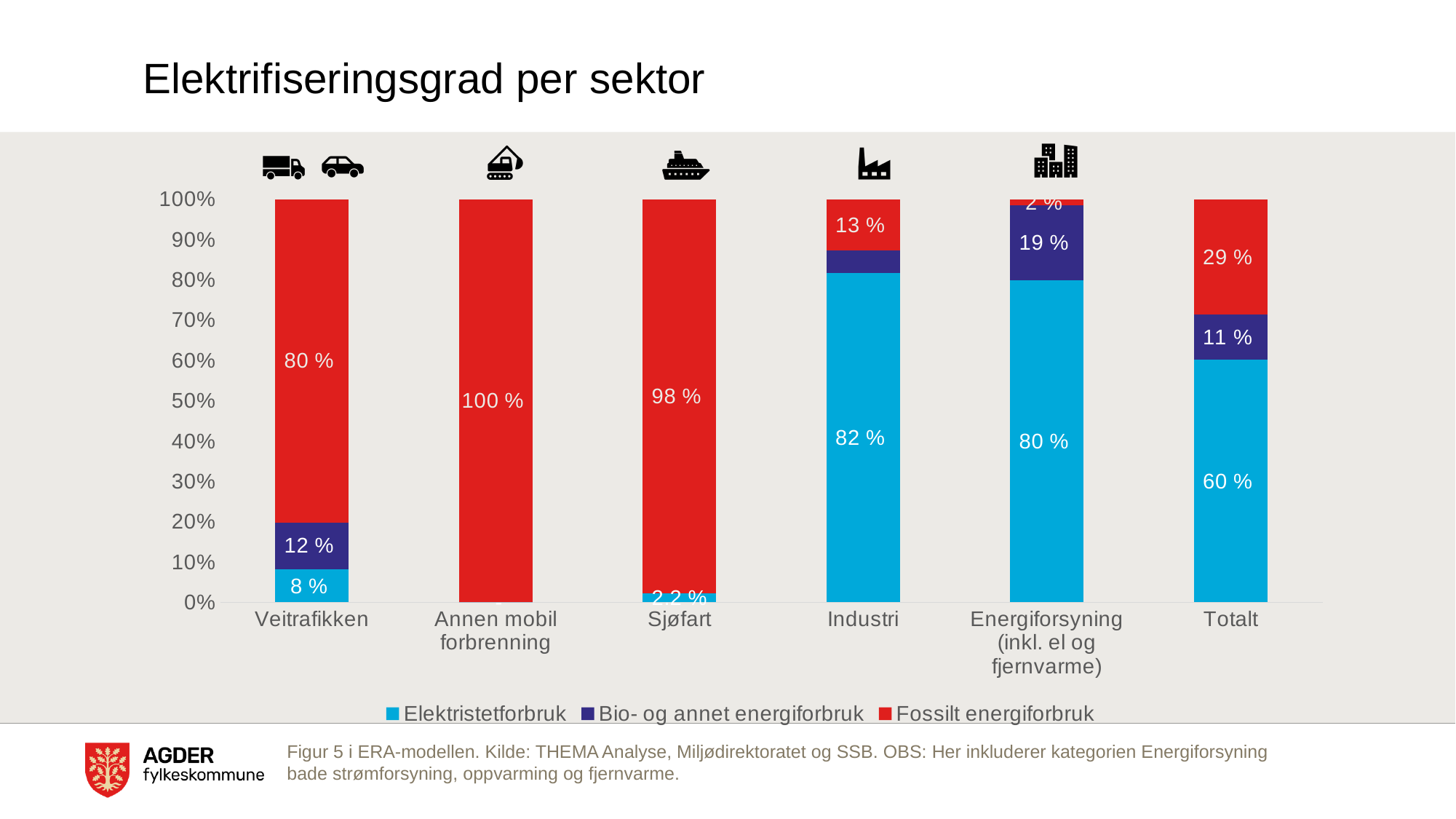
What is the Fossilt energiforbruk value for Sjøfart? 98 % Is the Elektristetforbruk value for Industri larger than that for Energiforsyning (inkl. el og fjernvarme)? Yes What kind of chart is shown on the slide? Stacked bar chart What is the Elektristetforbruk value for Totalt? 60 % What is the Bio- og annet energiforbruk value for Energiforsyning (inkl. el og fjernvarme)? 19 % How many series does the legend list? 3 What is the Elektristetforbruk value for Industri? 82 % How many categories are shown on the x axis? 6 Which category has the lowest Elektristetforbruk share among those with a labelled value? Sjøfart What is the difference between the Fossilt energiforbruk values for Totalt and Industri? 16 % What is the Fossilt energiforbruk value for Veitrafikken? 80 % Which category has the highest Fossilt energiforbruk share? Annen mobil forbrenning